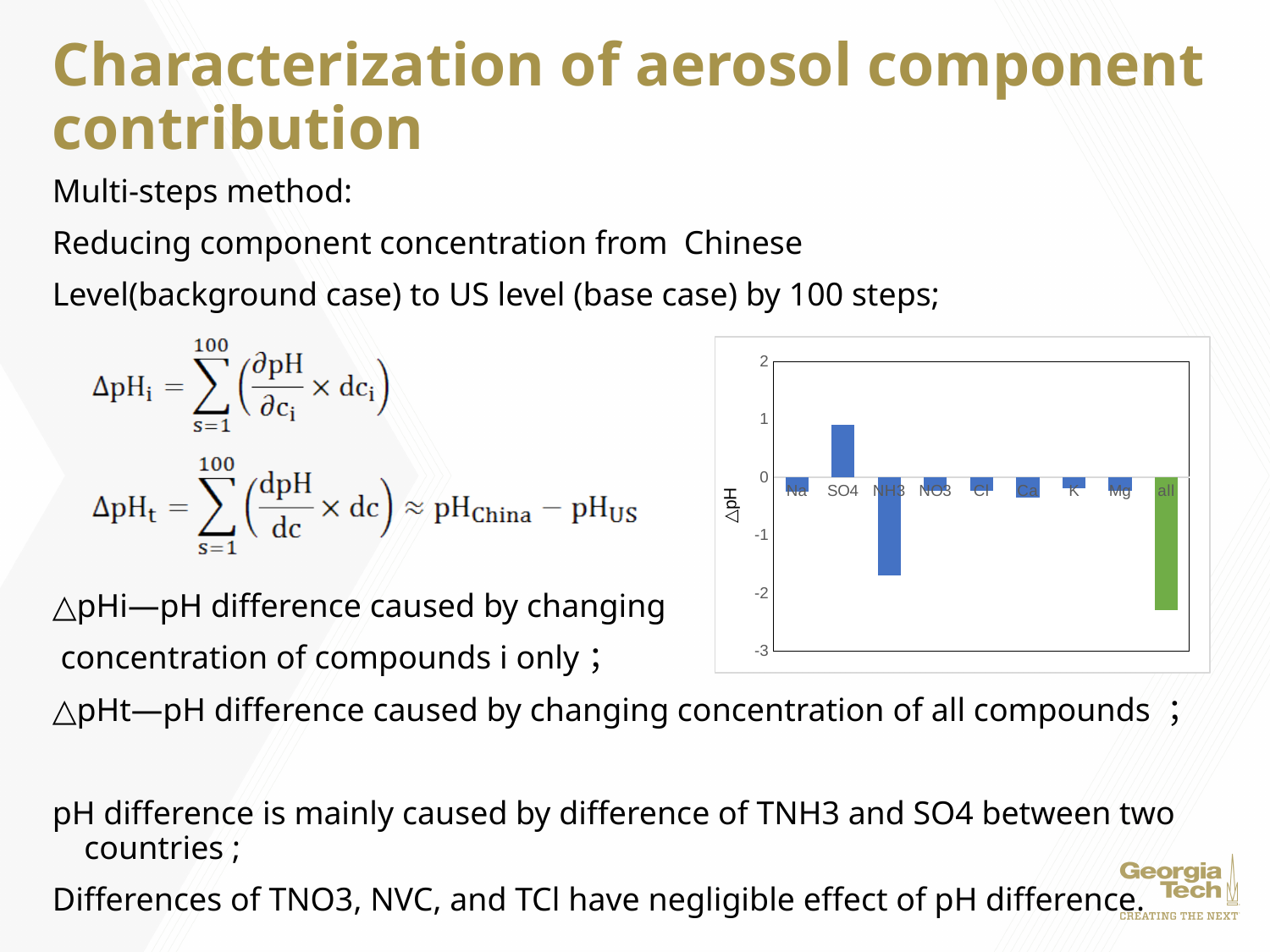
Is the value for Na greater or less than -1? greater How many categories are plotted on the x axis of the chart? 9 Which has the larger value, NH3 or all? NH3 Is the value for SO4 greater or less than 1? less What kind of chart is shown on the slide? bar chart Is the value for NH3 greater or less than -1? less Which has the larger value, SO4 or NH3? SO4 How many bars in the chart have a positive value? 1 Which category has the lowest value in the chart? all What is the label on the y axis of the chart? △pH Which category has the highest value in the chart? SO4